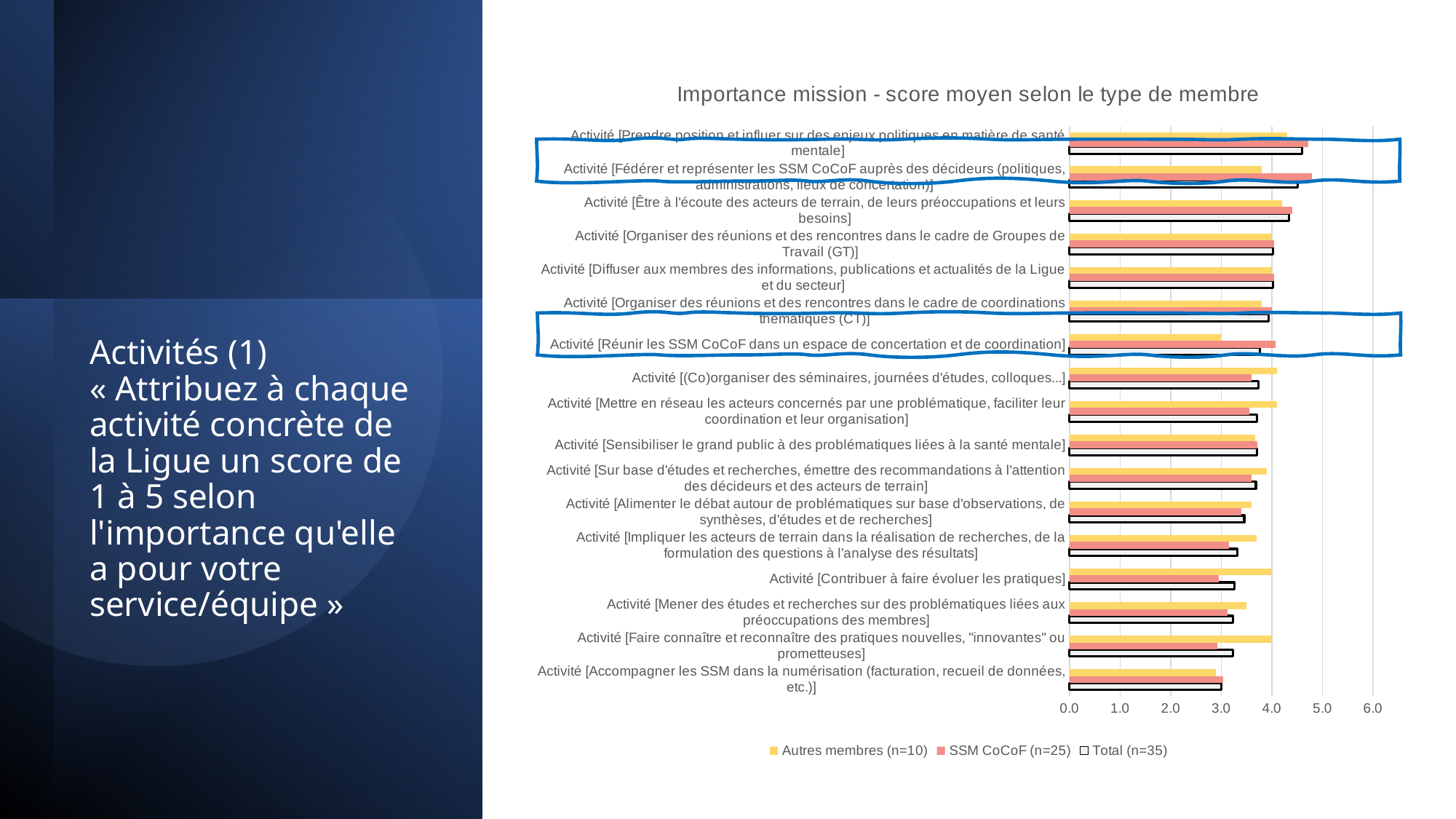
Which series in the legend has n=25? SSM CoCoF (n=25) What type of chart is shown on the slide? Bar chart What is the title of the chart? Importance mission - score moyen selon le type de membre For 'Activité [Réunir les SSM CoCoF dans un espace de concertation et de coordination]', which series has the larger value: Autres membres or SSM CoCoF? SSM CoCoF How many series does the legend of the chart list? 3 How many activities (categories) are plotted in the chart? 17 For 'Activité [Faire connaître et reconnaître des pratiques nouvelles, "innovantes" ou prometteuses]', which series has the larger value: Autres membres or SSM CoCoF? Autres membres Is the Total value for 'Activité [Fédérer et représenter les SSM CoCoF auprès des décideurs (politiques, administrations, lieux de concertation)]' greater or less than 4.0? greater Is the SSM CoCoF value for 'Activité [Prendre position et influer sur des enjeux politiques en matière de santé mentale]' greater or less than 4.0? greater Going from the top activity to the bottom activity, do the Total values generally rise or fall? fall For 'Activité [Contribuer à faire évoluer les pratiques]', which series has the larger value: Autres membres or SSM CoCoF? Autres membres Is the Total value for 'Activité [Impliquer les acteurs de terrain dans la réalisation de recherches, de la formulation des questions à l'analyse des résultats]' greater or less than 4.0? less